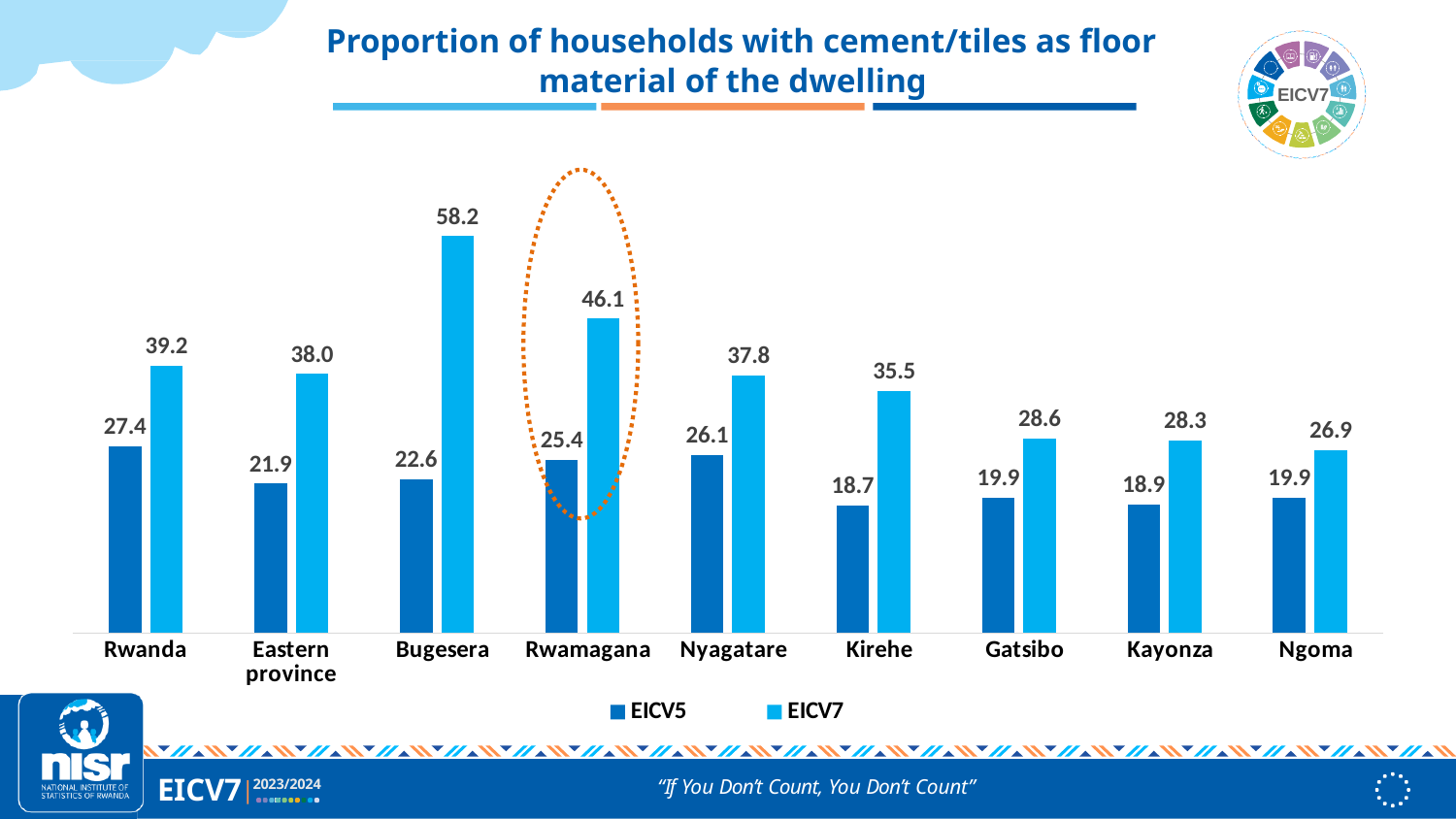
What is the EICV7 value for Kirehe? 35.5 How many series does the legend list? 2 What is the EICV7 value for Bugesera? 58.2 What is the difference between the EICV7 and EICV5 values for Bugesera? 35.6 What is the EICV5 value for Rwanda? 27.4 Which is larger, the EICV7 value for Nyagatare or the EICV7 value for Eastern province? Eastern province What is the EICV5 value for Rwamagana? 25.4 Which category is highlighted with a dotted orange oval? Rwamagana Which category has the lowest EICV5 value? Kirehe What kind of chart is shown on the slide? Bar chart Which category has the highest EICV7 value? Bugesera How many categories are shown on the x axis? 9